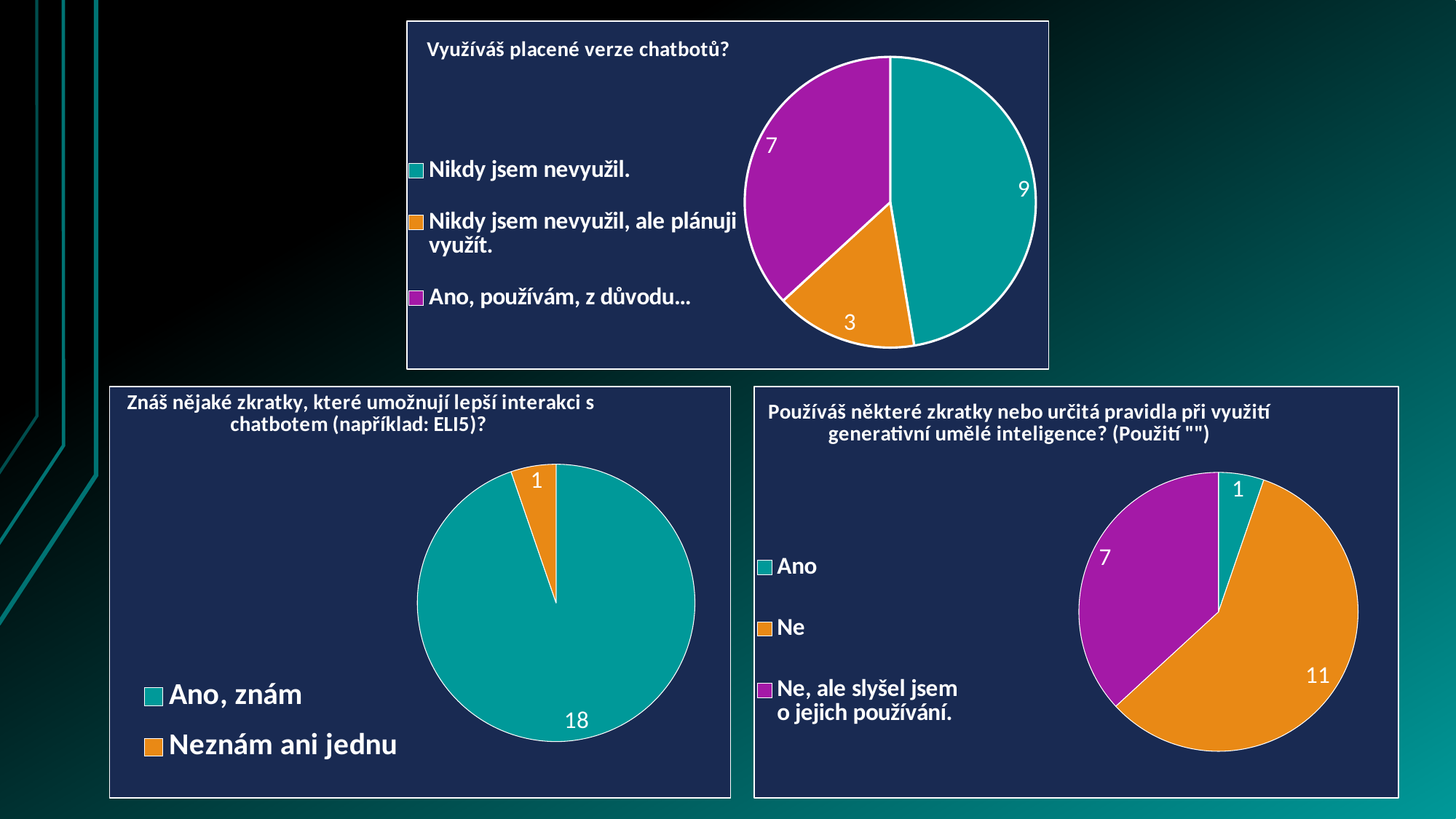
In the bottom-right chart about using shortcuts or rules with generative AI, which is larger: "Ano" or "Ne, ale slyšel jsem o jejich používání."? Ne, ale slyšel jsem o jejich používání. In the bottom-left chart about knowing shortcuts (ELI5), what is the value for "Ano, znám"? 18 In the chart titled "Využíváš placené verze chatbotů?", what is the value for "Nikdy jsem nevyužil."? 9 In the bottom-left chart about knowing shortcuts (ELI5), what is the value for "Neznám ani jednu"? 1 In the chart titled "Využíváš placené verze chatbotů?", how many categories does the legend list? 3 In the bottom-left chart about knowing shortcuts (ELI5), what is the total of all slices? 19 In the chart titled "Využíváš placené verze chatbotů?", what is the difference between "Nikdy jsem nevyužil." and "Ano, používám, z důvodu…"? 2 In the chart titled "Využíváš placené verze chatbotů?", which category has the smallest slice? Nikdy jsem nevyužil, ale plánuji využít. In the bottom-right chart about using shortcuts or rules with generative AI, what is the value for "Ne"? 11 In the bottom-right chart about using shortcuts or rules with generative AI, which category has the largest slice? Ne What type of chart is used in the bottom-right chart about using shortcuts or rules with generative AI? Pie chart In the bottom-left chart about knowing shortcuts (ELI5), what colour is the "Ano, znám" slice? Teal